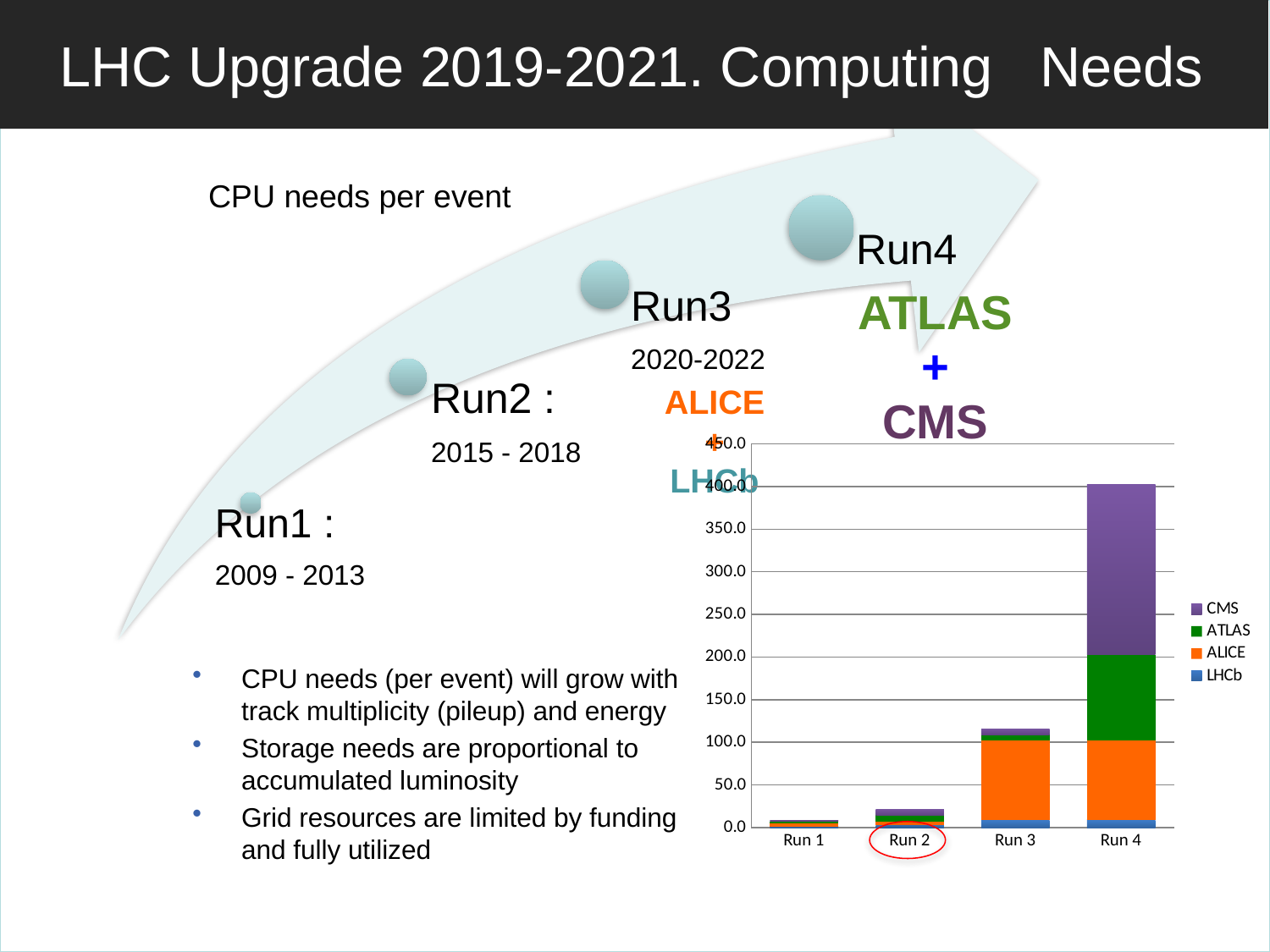
Which x-axis category label is circled in red on the chart? Run 2 How many categories (runs) are shown on the x axis of the chart? 4 Is the total height of the Run 4 bar greater or less than 350.0? greater Do the stacked bar totals rise or fall from Run 1 to Run 4? rise Is the total height of the Run 2 bar greater or less than 50.0? less Is the total height of the Run 3 bar greater or less than 100.0? greater Which stacked bar is taller, Run 3 or Run 2? Run 3 Which run has the tallest stacked bar in the chart? Run 4 Which series is shown in purple in the chart's legend? CMS Which run has the shortest stacked bar in the chart? Run 1 How many series does the chart's legend list? 4 What kind of chart is shown on the slide? Stacked bar chart